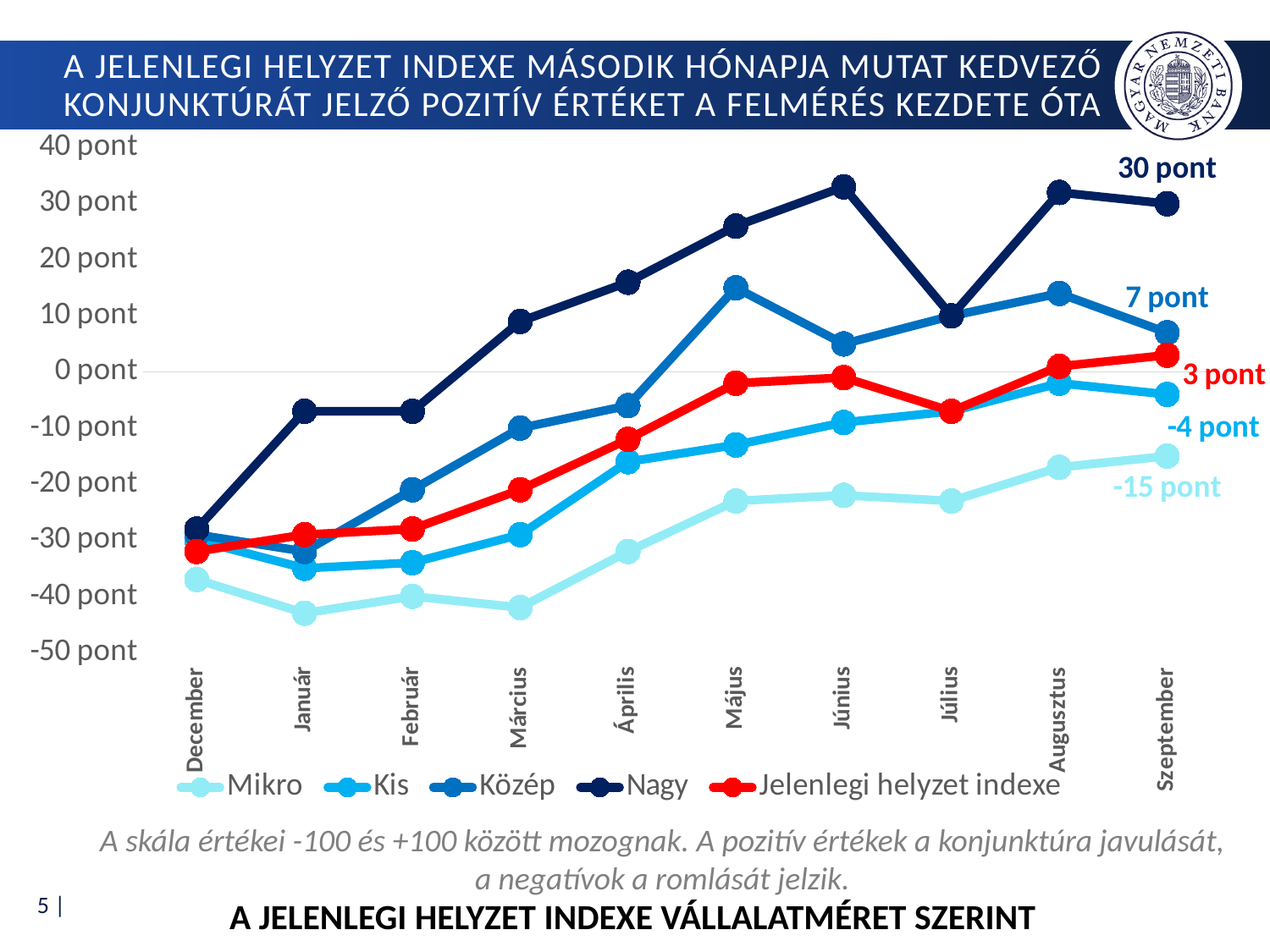
What is the value of the Mikro series in Szeptember? -15 pont What is the difference between the Nagy and Mikro values in Szeptember? 45 pont What is the value of the Nagy series in Szeptember? 30 pont What is the value of the Jelenlegi helyzet indexe series in Szeptember? 3 pont How many months are shown on the x axis? 10 What is the value of the Közép series in Szeptember? 7 pont What kind of chart is shown on the slide? line chart Does the Mikro series rise or fall overall from December to Szeptember? rise Is the value for Mikro in Január greater or less than -40 pont? less What is the value of the Kis series in Szeptember? -4 pont Which series has the highest value in Szeptember? Nagy How many series does the legend list? 5